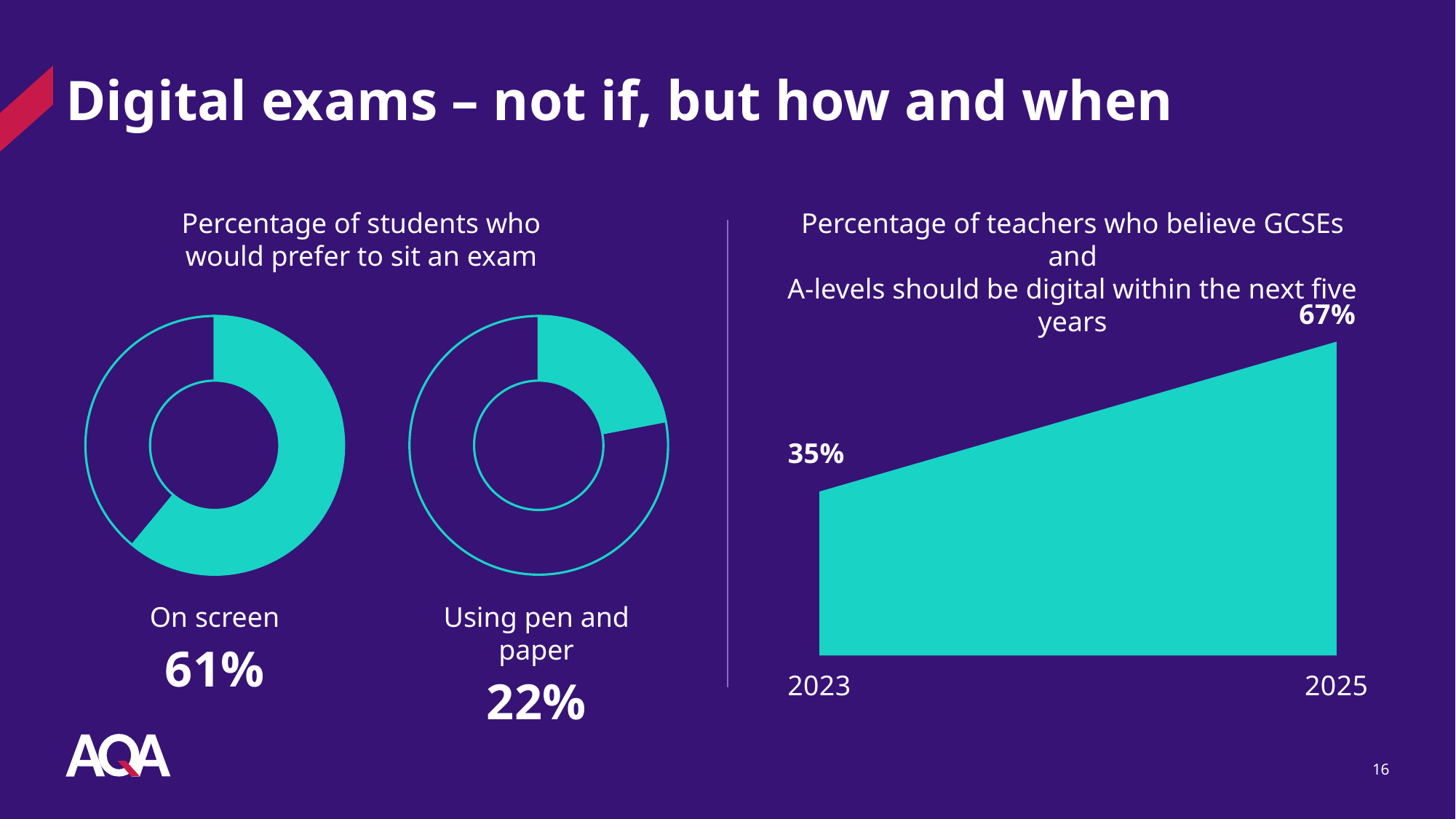
In the 'Percentage of students who would prefer to sit an exam' charts, what kind of chart is used to show each percentage? Donut (pie) chart In the chart on the right about teachers who believe GCSEs and A-levels should be digital within the next five years, what is the value for 2023? 35% In the chart on the right, which year has the higher percentage of teachers who believe GCSEs and A-levels should be digital, 2023 or 2025? 2025 In the chart on the right about teachers who believe GCSEs and A-levels should be digital, by how many percentage points did the value increase from 2023 to 2025? 32 percentage points In the 'Percentage of students who would prefer to sit an exam' charts, what is the difference between the 'On screen' and 'Using pen and paper' percentages? 39 percentage points In the 'Percentage of students who would prefer to sit an exam' charts, what percentage of students would prefer to sit an exam using pen and paper? 22% In the 'Percentage of students who would prefer to sit an exam' charts, what percentage of students would prefer to sit an exam on screen? 61% In the 'Percentage of students who would prefer to sit an exam' charts, which option has the higher percentage, 'On screen' or 'Using pen and paper'? On screen How many years are labelled on the x axis of the chart on the right about teachers who believe GCSEs and A-levels should be digital? 2 What kind of chart is the chart on the right about teachers who believe GCSEs and A-levels should be digital? Area chart In the chart on the right about teachers who believe GCSEs and A-levels should be digital, does the value rise or fall from 2023 to 2025? Rises In the chart on the right about teachers who believe GCSEs and A-levels should be digital within the next five years, what is the value for 2025? 67%